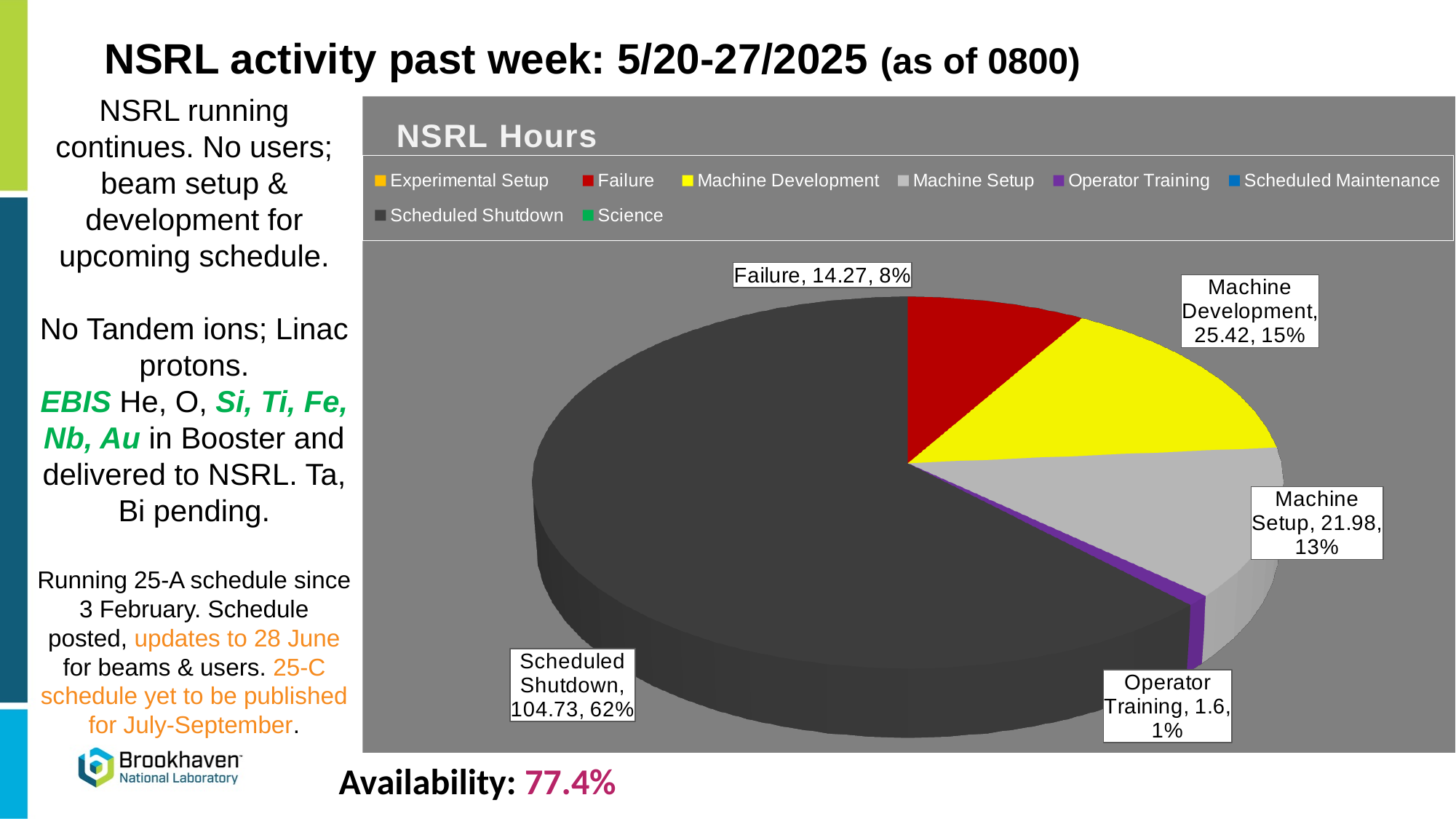
How many hours are shown for Failure? 14.27 How many hours are shown for Machine Development? 25.42 How many hours are shown for Scheduled Shutdown? 104.73 What share of the pie does Scheduled Shutdown represent? 62% What is the difference in hours between Machine Development and Machine Setup? 3.44 What share of the pie does Machine Setup represent? 13% What is the title of the chart? NSRL Hours Which labelled category has the smallest slice of the pie? Operator Training How many hours are shown for Operator Training? 1.6 How many entries does the legend of the NSRL Hours chart list? 8 What kind of chart is the NSRL Hours chart? pie chart Which labelled category has the largest slice of the pie? Scheduled Shutdown